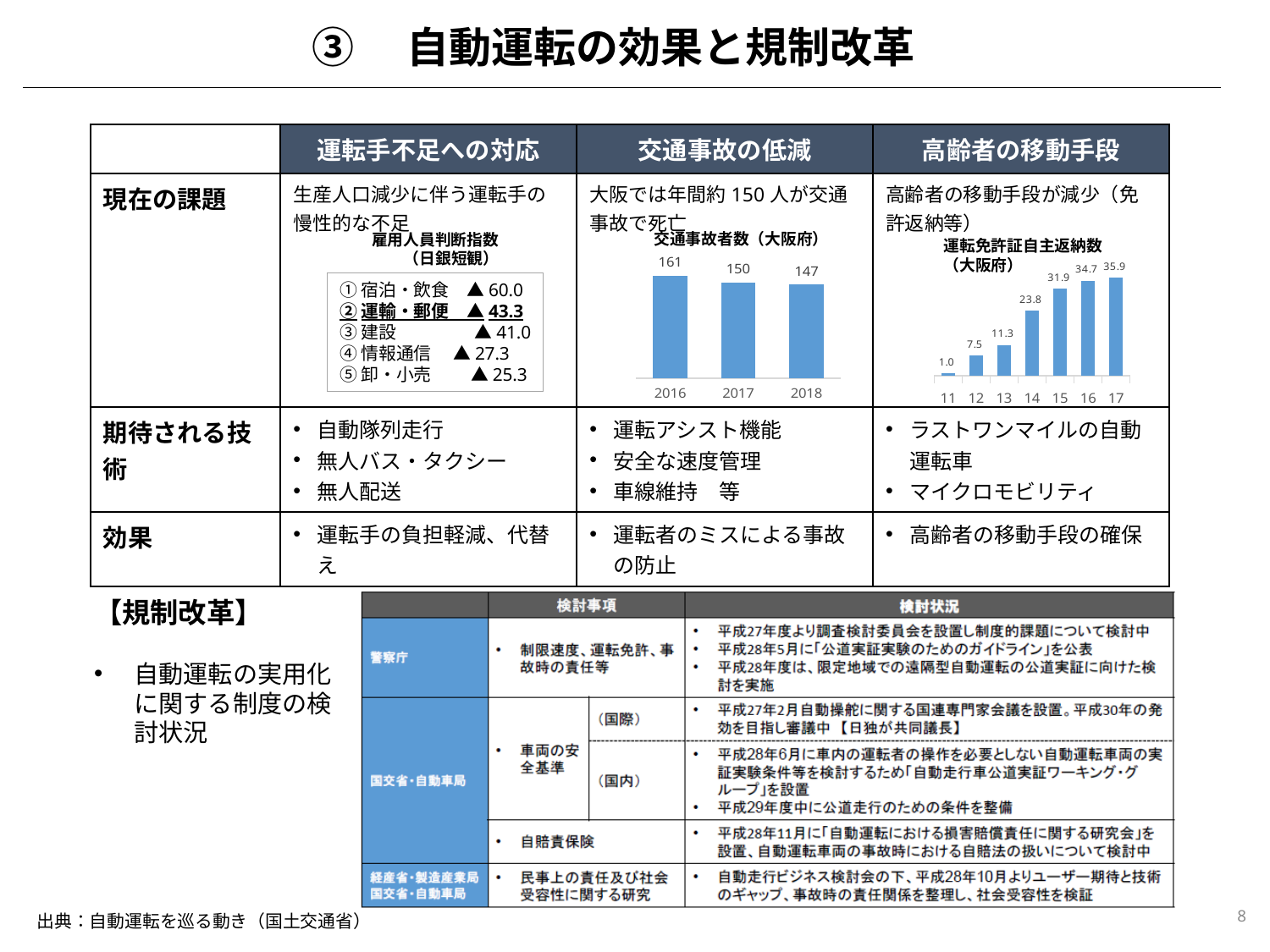
In the 交通事故者数（大阪府） chart, what is the value for 2018? 147 In the 交通事故者数（大阪府） chart, which year has the highest value? 2016 In the 運転免許証自主返納数（大阪府） chart, which category has the lowest value? 11 In the 交通事故者数（大阪府） chart, what is the difference between the 2016 and 2017 values? 11 How many bars are in the 運転免許証自主返納数（大阪府） chart? 7 In the 運転免許証自主返納数（大阪府） chart, what is the difference between the values for 15 and 14? 8.1 What kind of chart is the 運転免許証自主返納数（大阪府） chart? bar chart In the 交通事故者数（大阪府） chart, what is the value for 2016? 161 In the 運転免許証自主返納数（大阪府） chart, what is the value for 14? 23.8 How many bars are in the 交通事故者数（大阪府） chart? 3 In the 運転免許証自主返納数（大阪府） chart, what is the value for 17? 35.9 In the 交通事故者数（大阪府） chart, do the values rise or fall from 2016 to 2018? fall